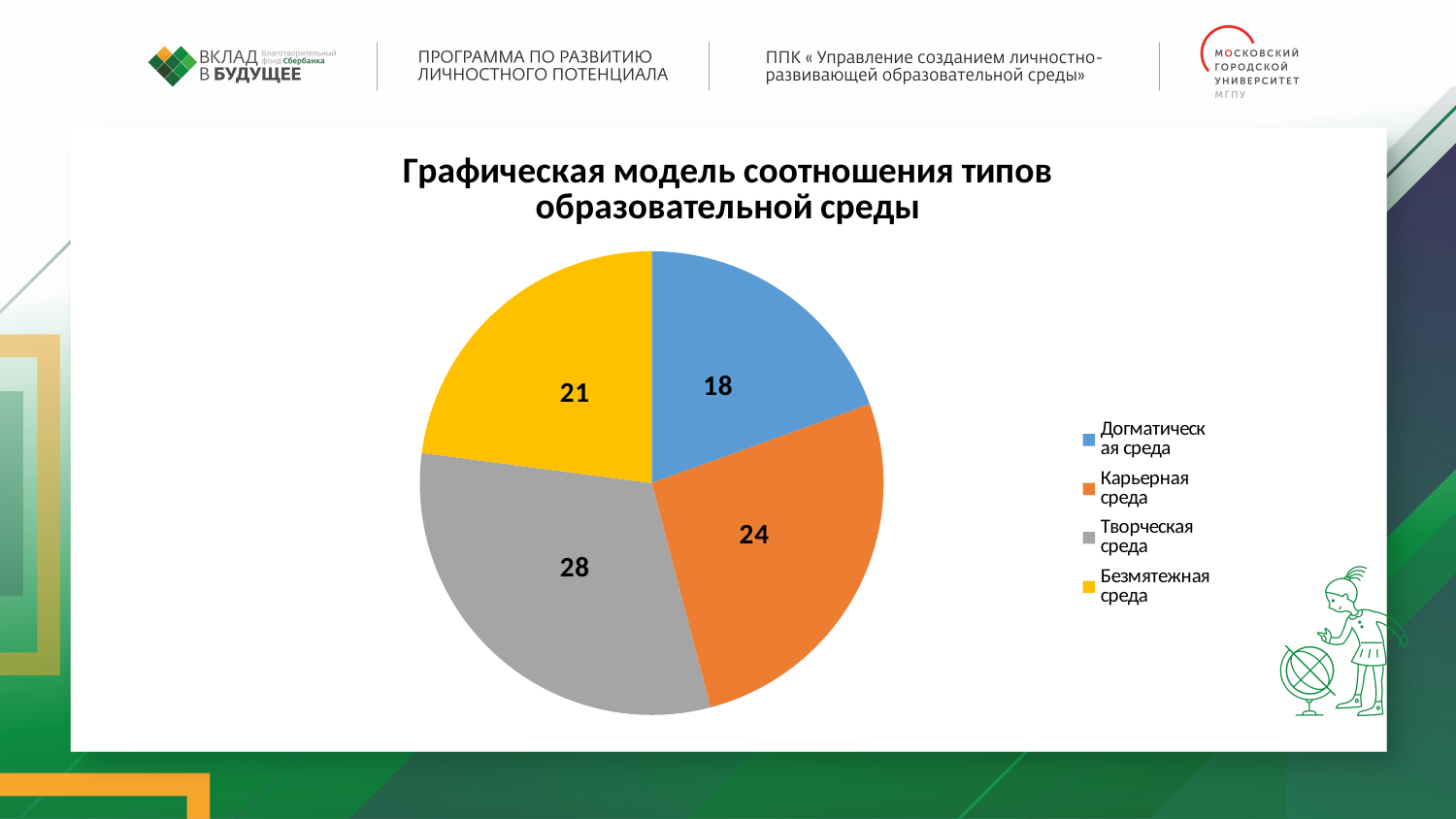
What is the title of the chart? Графическая модель соотношения типов образовательной среды Which is larger, the value for Карьерная среда or the value for Безмятежная среда? Карьерная среда What is the value for Карьерная среда? 24 What type of chart is shown on the slide? Pie chart How many slices does the pie chart have? 4 What is the value for Догматическая среда? 18 How many entries does the legend list? 4 What is the value for Творческая среда? 28 What is the value for Безмятежная среда? 21 Which type of educational environment has the smallest slice? Догматическая среда Which type of educational environment has the largest slice? Творческая среда What is the difference between the values for Творческая среда and Догматическая среда? 10